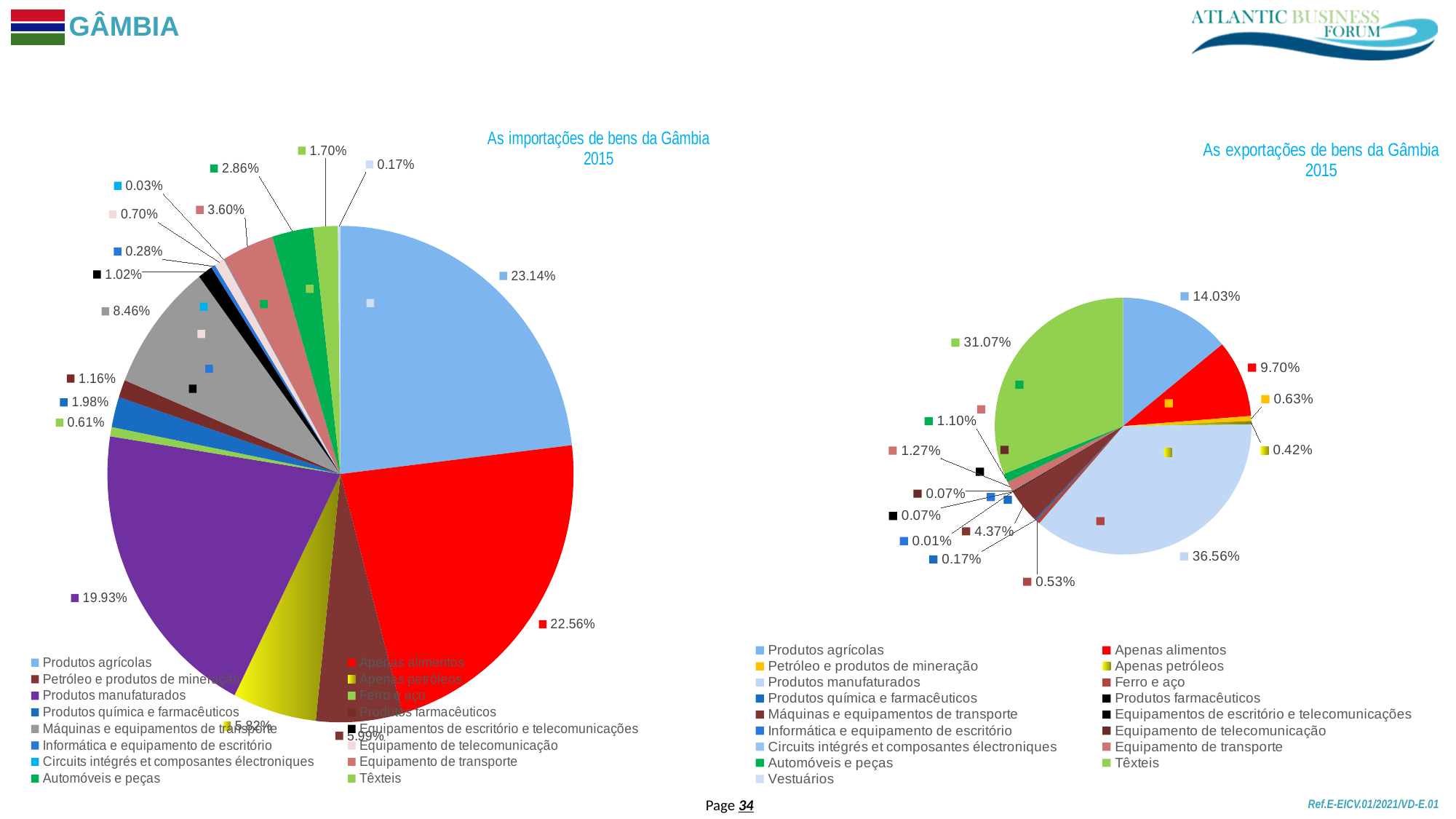
In the chart 'As exportações de bens da Gâmbia 2015', what share is shown for Apenas alimentos? 9.70% In the chart 'As importações de bens da Gâmbia 2015', what share is shown for Produtos agrícolas? 23.14% In the chart 'As importações de bens da Gâmbia 2015', which is larger: Apenas alimentos or Apenas petróleos? Apenas alimentos In the chart 'As importações de bens da Gâmbia 2015', what is the difference between the shares of Produtos agrícolas and Apenas alimentos? 0.58% In the chart 'As importações de bens da Gâmbia 2015', what share is shown for Máquinas e equipamentos de transporte? 8.46% In the chart 'As importações de bens da Gâmbia 2015', which category has the largest share? Produtos agrícolas In the chart 'As exportações de bens da Gâmbia 2015', what share is shown for Têxteis? 31.07% In the chart 'As exportações de bens da Gâmbia 2015', what share is shown for Produtos manufaturados? 36.56% In the chart 'As exportações de bens da Gâmbia 2015', what is the difference between the shares of Produtos manufaturados and Têxteis? 5.49% What kind of chart is used for 'As exportações de bens da Gâmbia 2015'? Pie chart In the chart 'As importações de bens da Gâmbia 2015', what share is shown for Produtos manufaturados? 19.93% In the chart 'As importações de bens da Gâmbia 2015', what share is shown for Automóveis e peças? 2.86%